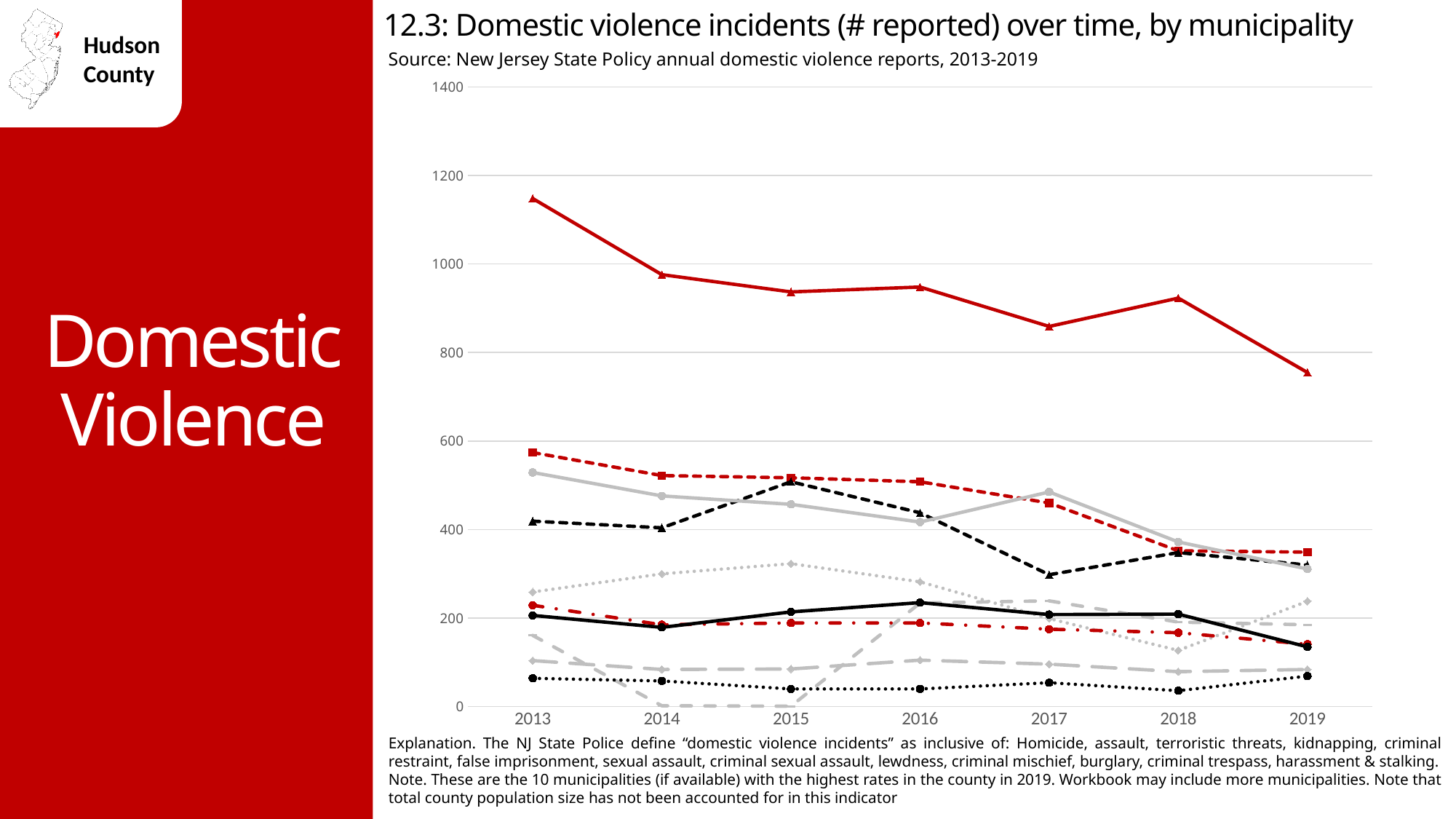
Is the value of the solid red line with triangle markers in 2019 greater or less than 800? less Does the solid red line with triangle markers generally rise or fall from 2013 to 2019? fall What is the first year shown on the x axis? 2013 In which year does the solid red line with triangle markers reach its highest value? 2013 Is the value of the black dotted line with circle markers in 2019 greater or less than 200? less Is the value of the solid red line with triangle markers in 2017 greater or less than 800? greater What is the title of the chart? 12.3: Domestic violence incidents (# reported) over time, by municipality For the solid red line with triangle markers, is the value larger in 2013 or in 2019? 2013 How many years are shown along the x axis of the chart? 7 In which year does the solid red line with triangle markers reach its lowest value? 2019 What kind of chart is shown on the slide? line chart